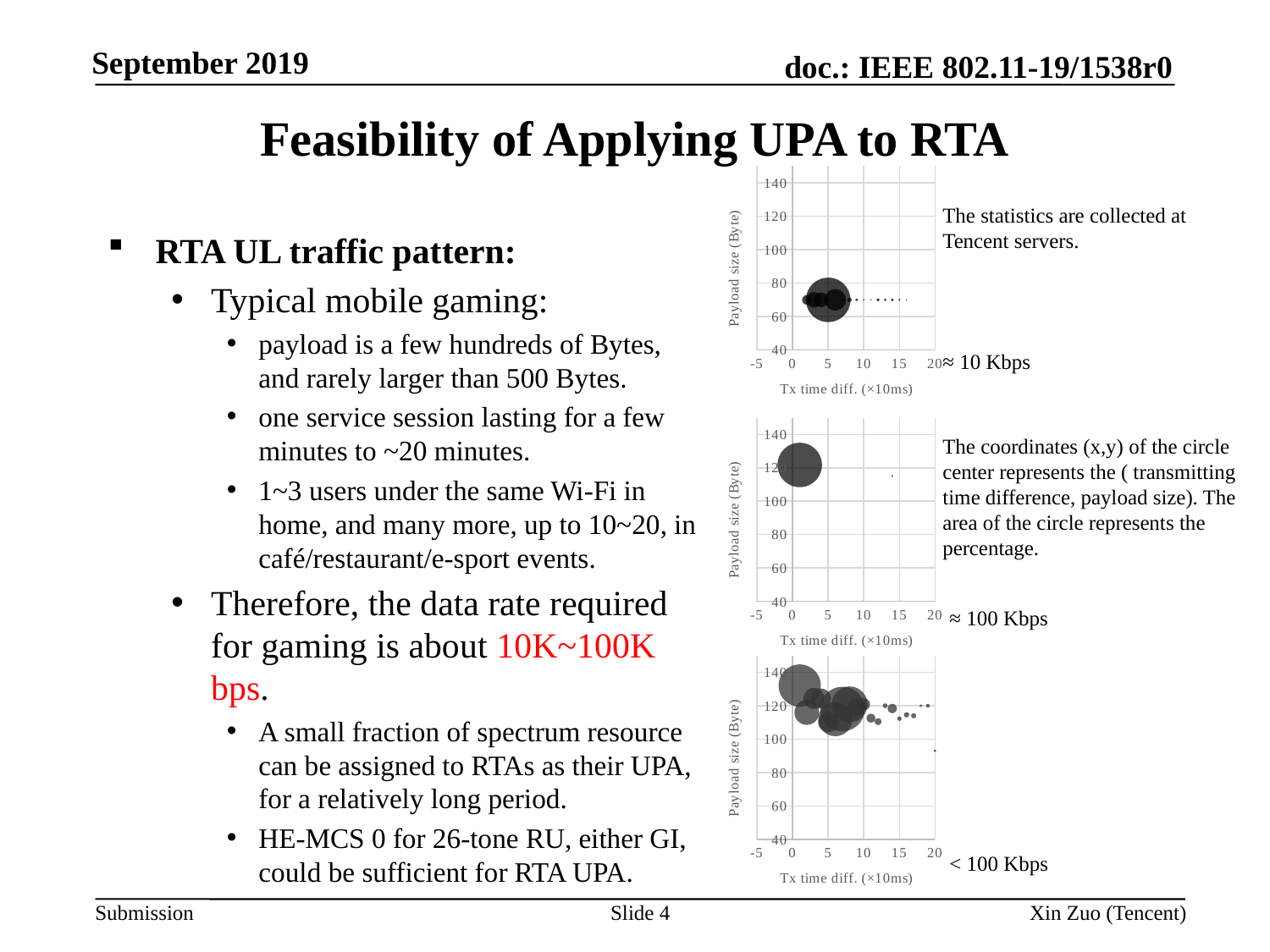
Which chart has its circles centred at a lower payload size: the top chart (≈ 10 Kbps) or the middle chart (≈ 100 Kbps)? the top chart (≈ 10 Kbps) In the top chart (labelled ≈ 10 Kbps), is the payload size of the large cluster of circles greater or less than 60 Bytes? greater What is the label of the x axis on the bottom chart? Tx time diff. (×10ms) In the middle chart (labelled ≈ 100 Kbps), is the Tx time difference of the largest circle greater or less than 5 (×10ms)? less In the bottom chart (labelled < 100 Kbps), is the payload size of the largest circles greater or less than 100 Bytes? greater How many charts are shown on the slide? 3 What kind of chart is the top chart on the right side of the slide? bubble chart What is the maximum value shown on the y axis of the middle chart? 140 What is the label of the y axis on the top chart? Payload size (Byte)